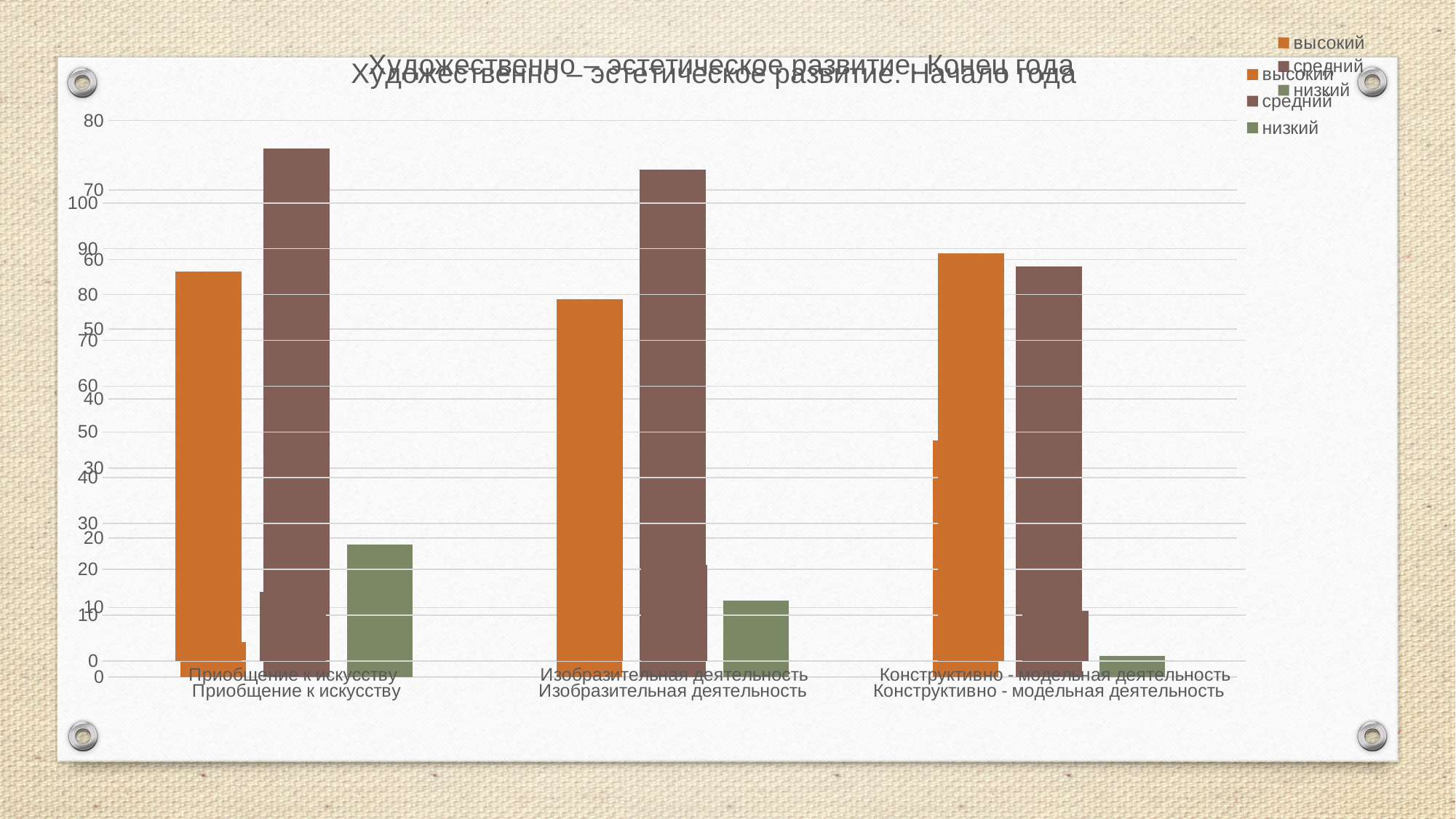
In the front chart (Начало года), for Изобразительная деятельность, which series has the shortest bar? низкий In the front chart (Начало года), for Приобщение к искусству, which series has the tallest bar? средний What are the three series named in the legend? высокий, средний, низкий How many series does the legend list? 3 What is the title of the chart drawn in front? Художественно – эстетическое развитие. Начало года What kind of chart is shown on the slide? bar chart In the front chart (Начало года), for Изобразительная деятельность, which bar is taller: высокий or средний? средний In the front chart (Начало года), do the средний bars rise or fall from left to right across the categories? fall In the front chart (Начало года), do the низкий bars rise or fall from left to right across the categories? fall In the front chart (Начало года), which category has the shortest низкий bar? Конструктивно - модельная деятельность How many categories are shown along the x axis? 3 In the front chart (Начало года), which category has the tallest средний bar? Приобщение к искусству